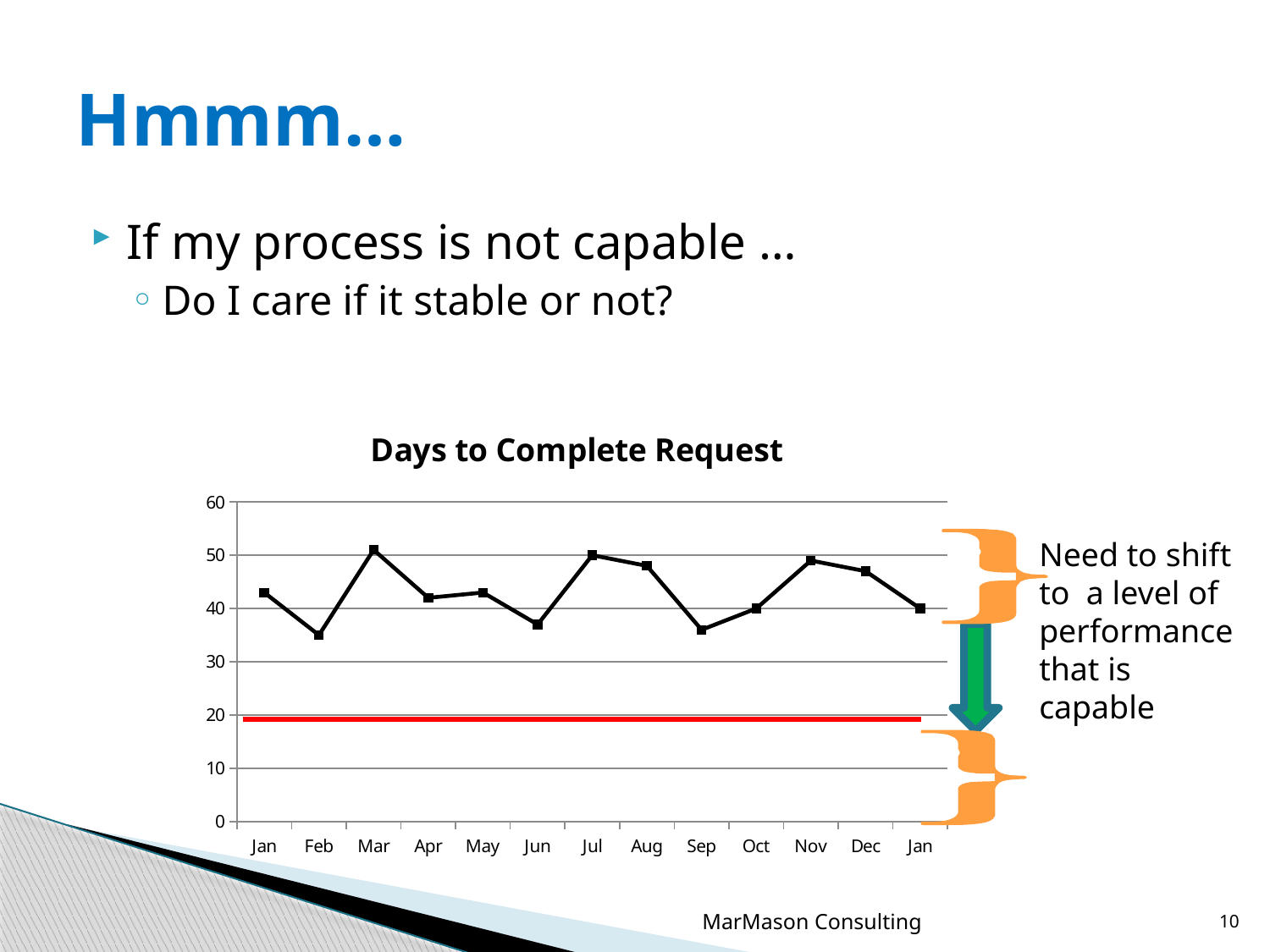
Is the value for Sep greater or less than 40? less Which is larger, the value for Sep or the value for Nov? Nov What is the title of the chart? Days to Complete Request Are all the plotted points above or below the red horizontal line? above How many data points are plotted on the line in the chart? 13 Which is larger, the value for Feb or the value for Mar? Mar Is the value for Feb greater or less than 40? less Is the value for Nov greater or less than 40? greater What kind of chart is shown on the slide? line chart Which is larger, the value for Jun or the value for Jul? Jul